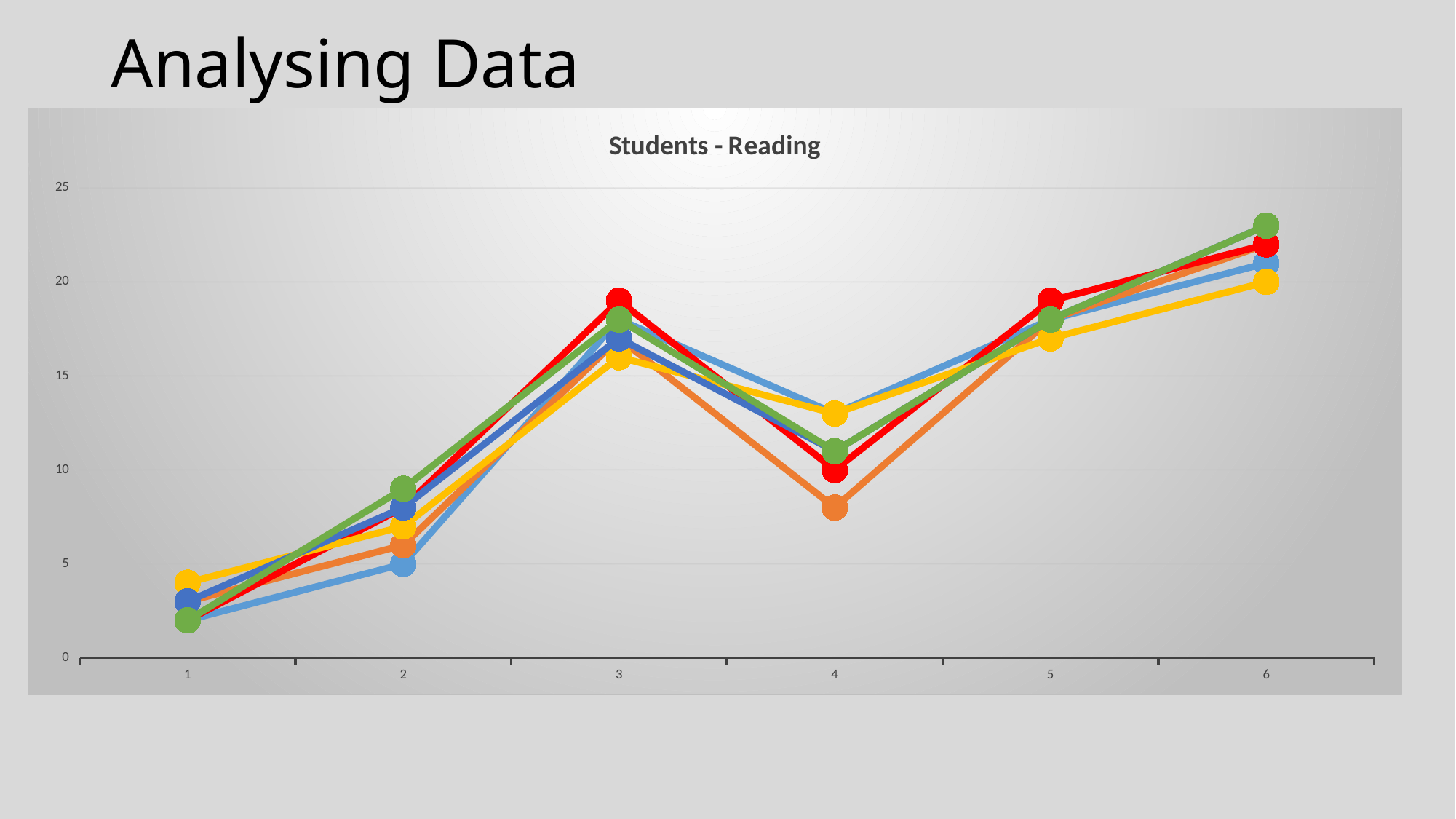
How many categories are shown along the x axis of the chart? 6 Do the values of the lines rise or fall between category 4 and category 6? rise What is the title of the chart? Students - Reading Is the value of the yellow line at category 1 greater or less than 5? less At category 4, which line has the higher value, the yellow line or the orange line? yellow line What is the highest value shown on the y axis of the chart? 25 Do the values of the lines rise or fall between category 3 and category 4? fall Is the value of the orange line at category 4 greater or less than 10? less At category 6, which line has the higher value, the green line or the yellow line? green line Is the value of the green line at category 6 greater or less than 20? greater What kind of chart is shown on the slide? line chart